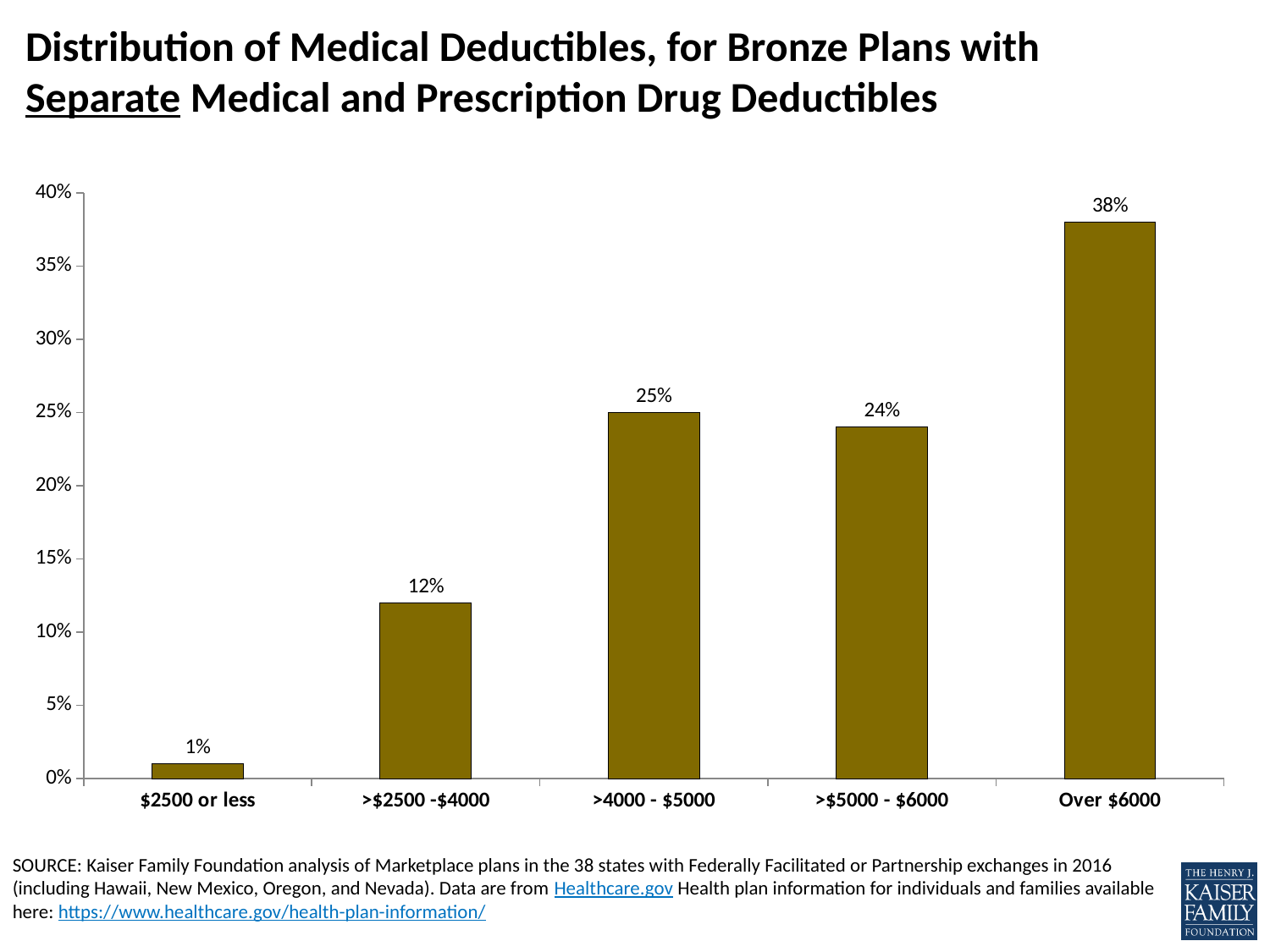
Which deductible category has the lowest share of plans? $2500 or less What is the maximum value shown on the vertical axis? 40% What percentage of plans fall in the >$5000 - $6000 deductible range? 24% Which is larger, the share for >$4000 - $5000 or the share for >$5000 - $6000? >$4000 - $5000 Which deductible category has the highest share of plans? Over $6000 Is the value for Over $6000 greater or less than 35%? greater How many deductible categories are shown on the x axis? 5 What is the difference between the Over $6000 share and the >$4000 - $5000 share? 13% What is the value shown for the >$2500 -$4000 category? 12% What is the combined share of the two highest deductible categories (>$5000 - $6000 and Over $6000)? 62% What percentage of bronze plans with separate deductibles have a medical deductible of $2500 or less? 1% What kind of chart is shown on the slide? Bar chart